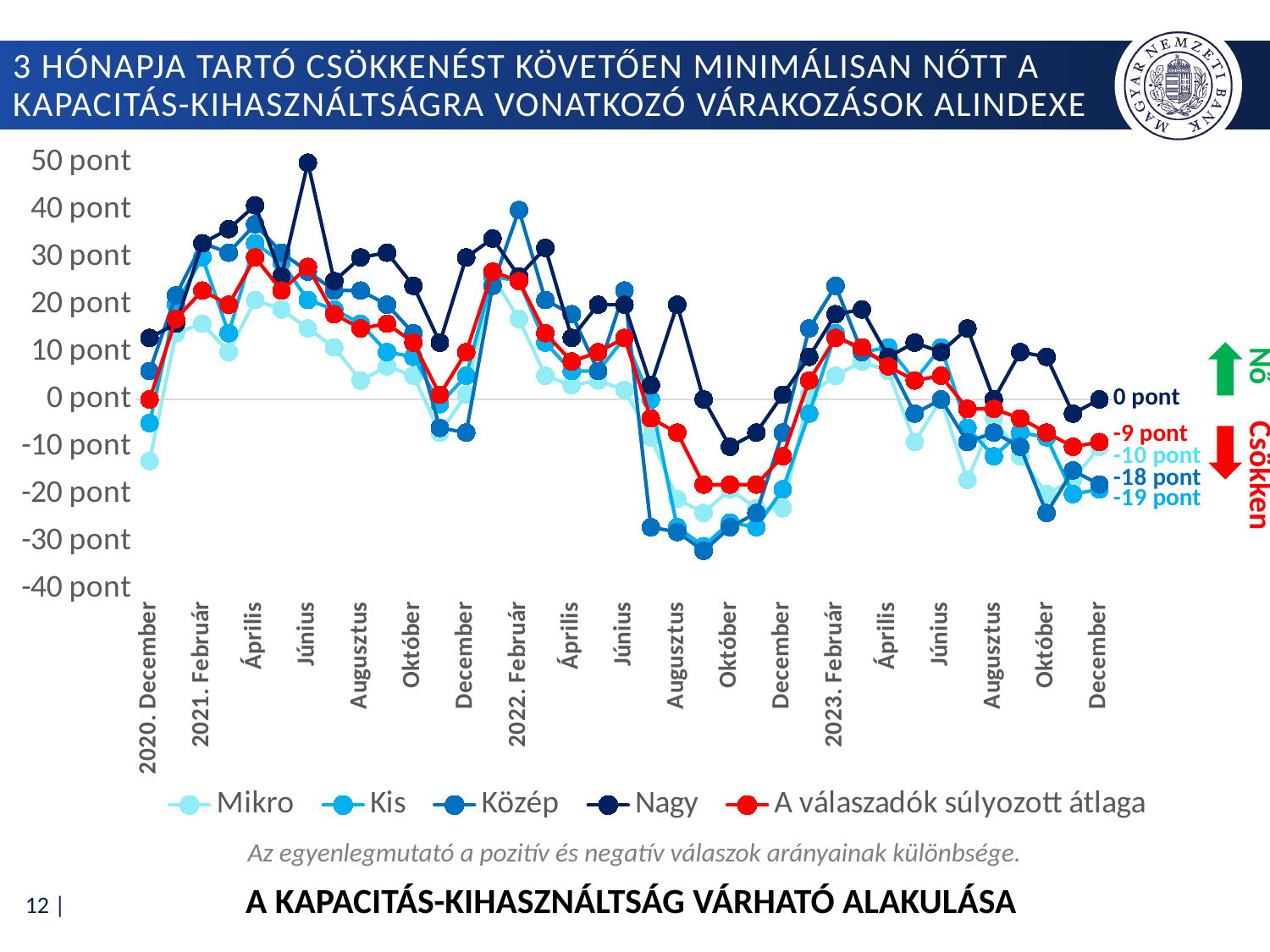
Is the value for Nagy in June 2021 greater or less than 40 pont? greater What is the value of the Nagy series in December 2023? 0 pont Is the value for 'A válaszadók súlyozott átlaga' in August 2022 greater or less than -10 pont? greater What is the value of 'A válaszadók súlyozott átlaga' in December 2023? -9 pont How many series does the legend list? 5 In December 2023, which is larger: the Nagy value or the 'A válaszadók súlyozott átlaga' value? Nagy What kind of chart is shown on the slide? line chart What is the difference between the Nagy value and the 'A válaszadók súlyozott átlaga' value in December 2023? 9 pont What colour is the line for 'A válaszadók súlyozott átlaga'? red Does the 'A válaszadók súlyozott átlaga' series rise or fall overall from February 2023 to December 2023? fall Which series has the highest value in December 2023? Nagy What is the value of the Mikro series in December 2023? -10 pont